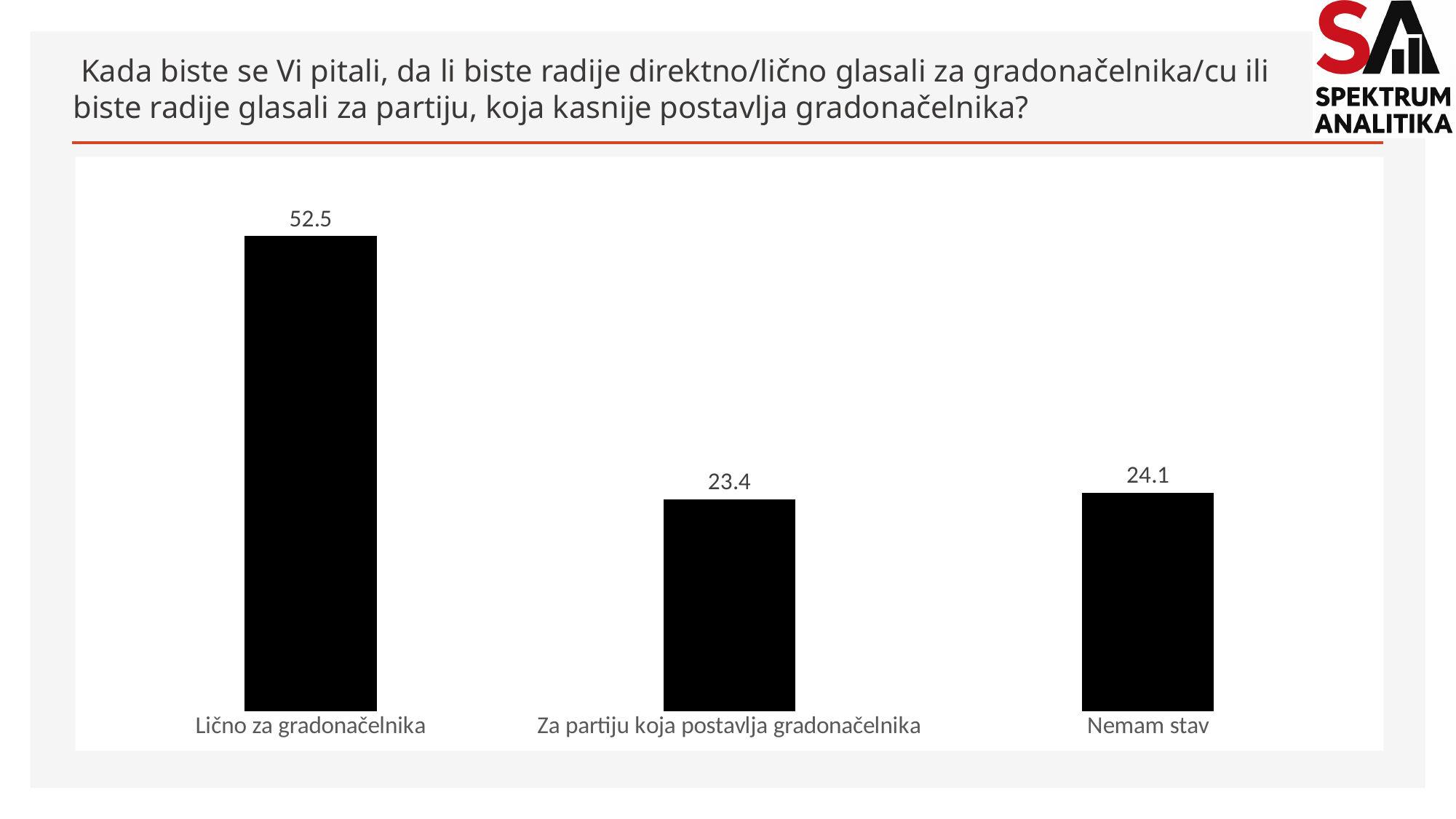
Which is larger: the value for "Lično za gradonačelnika" or the value for "Za partiju koja postavlja gradonačelnika"? Lično za gradonačelnika What is the difference between the values for "Lično za gradonačelnika" and "Nemam stav"? 28.4 Which category has the lowest value? Za partiju koja postavlja gradonačelnika What is the value for "Lično za gradonačelnika"? 52.5 What is the value for "Za partiju koja postavlja gradonačelnika"? 23.4 Which category has the highest value? Lično za gradonačelnika What is the difference between the values for "Nemam stav" and "Za partiju koja postavlja gradonačelnika"? 0.7 How many categories are shown in the chart? 3 What is the total of the three values shown in the chart? 100 What is the value for "Nemam stav"? 24.1 What kind of chart is shown on the slide? Bar chart What colour are the bars in the chart? Black